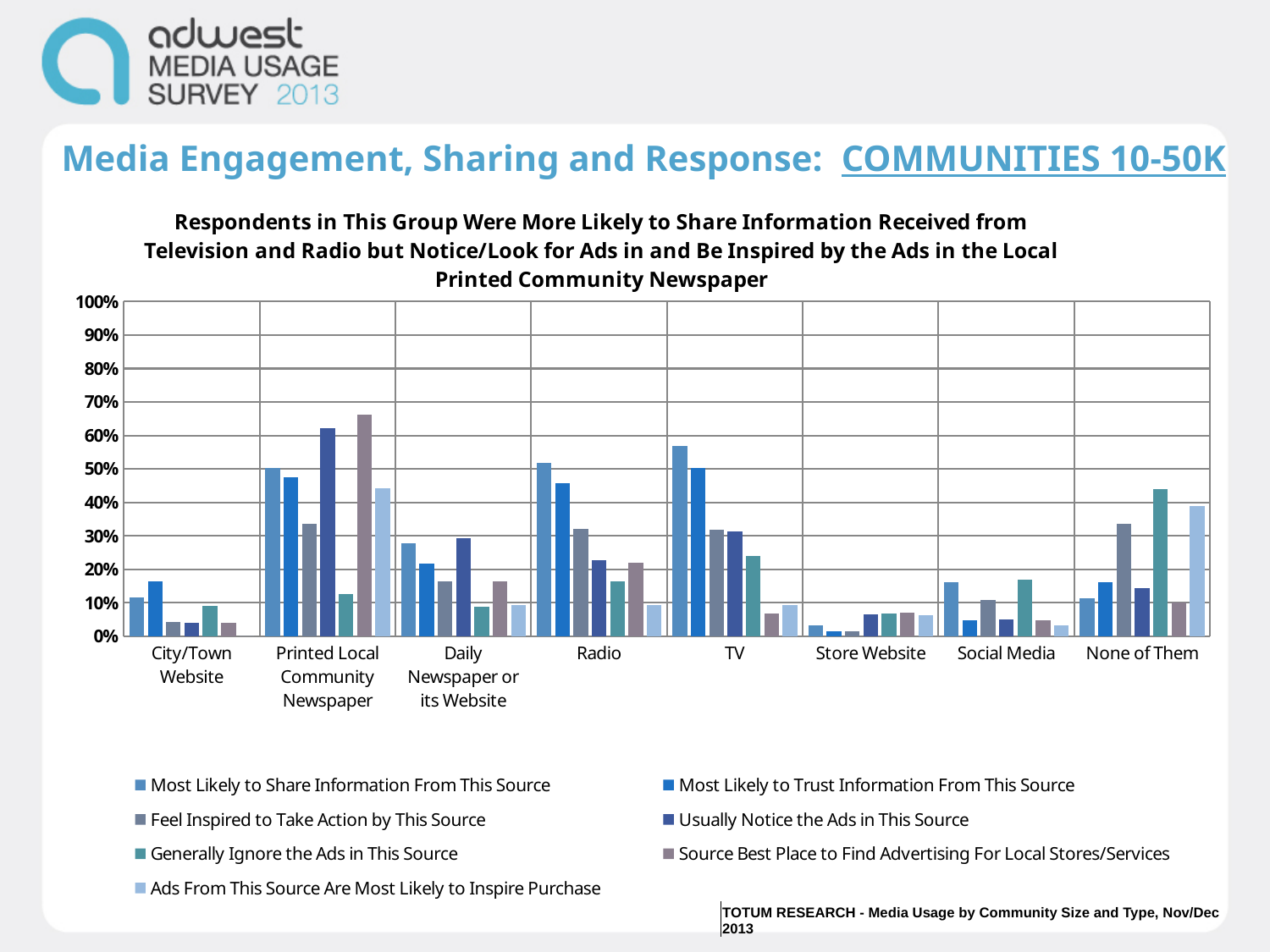
What kind of chart is shown on the slide? Bar chart How many series does the chart's legend list? 7 Is the value for 'Usually Notice the Ads in This Source' for Printed Local Community Newspaper greater or less than 50%? greater Is the value for 'Ads From This Source Are Most Likely to Inspire Purchase' for None of Them greater or less than 30%? greater How many source categories are shown along the x axis of the chart? 8 Which category has the lowest value for 'Most Likely to Share Information From This Source'? Store Website Is the value for 'Most Likely to Share Information From This Source' for TV greater or less than 50%? greater Which is larger: 'Most Likely to Share Information From This Source' for TV or for Printed Local Community Newspaper? TV What is the maximum value shown on the chart's y axis? 100% Which category has the highest value for 'Generally Ignore the Ads in This Source'? None of Them Which category has the highest value for 'Source Best Place to Find Advertising For Local Stores/Services'? Printed Local Community Newspaper